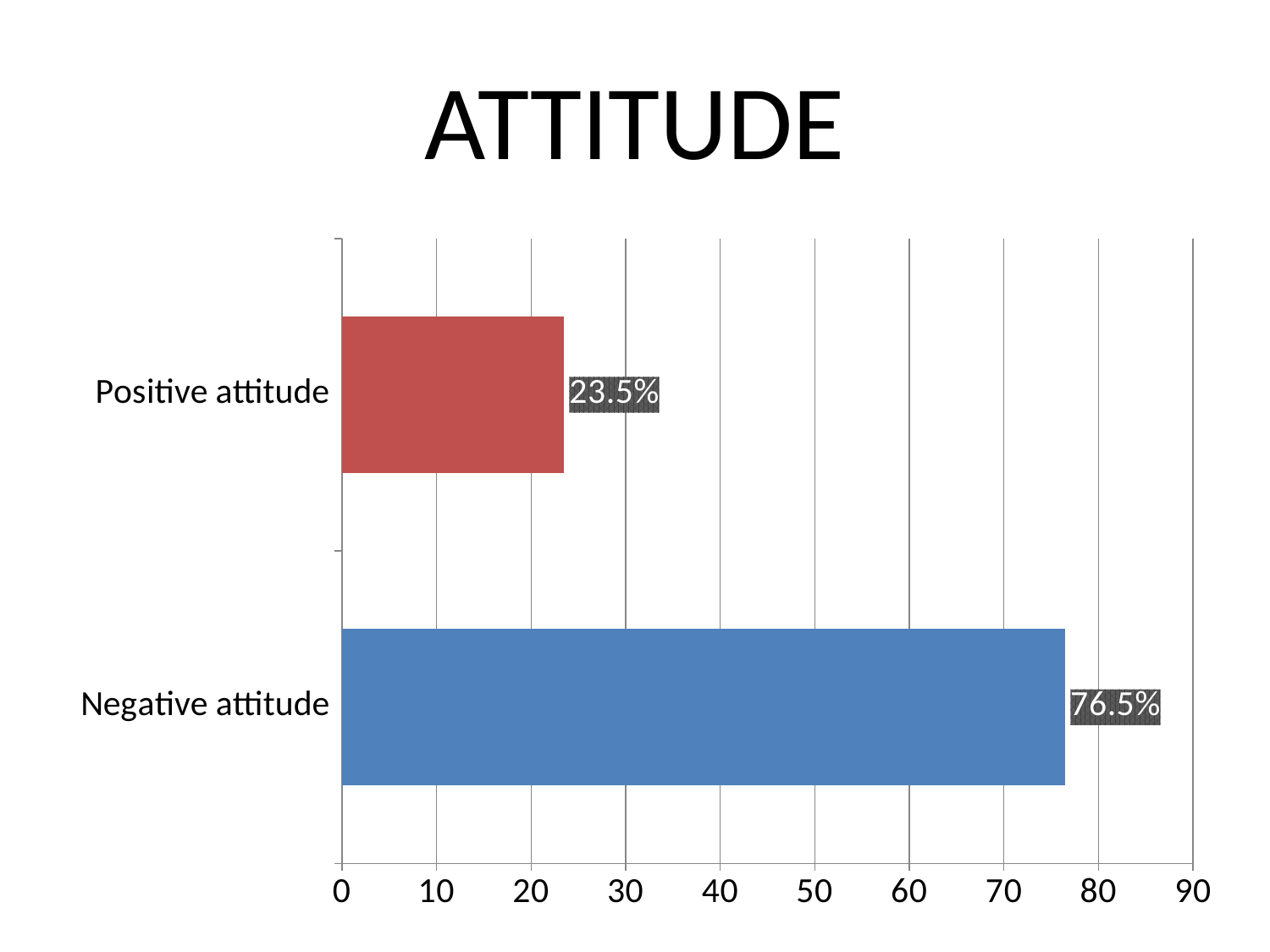
Which is larger, the value for Positive attitude or the value for Negative attitude? Negative attitude Is the value for Positive attitude greater or less than 30? less What is the value for Positive attitude? 23.5% What kind of chart is shown on the slide? Bar chart Which category has the highest value? Negative attitude What is the value for Negative attitude? 76.5% What is the title of the slide? ATTITUDE Which category has the lowest value? Positive attitude What colour is the bar for Negative attitude? Blue What is the difference between the values for Negative attitude and Positive attitude? 53% Is the value for Negative attitude greater or less than 70? greater How many categories are shown in the chart? 2